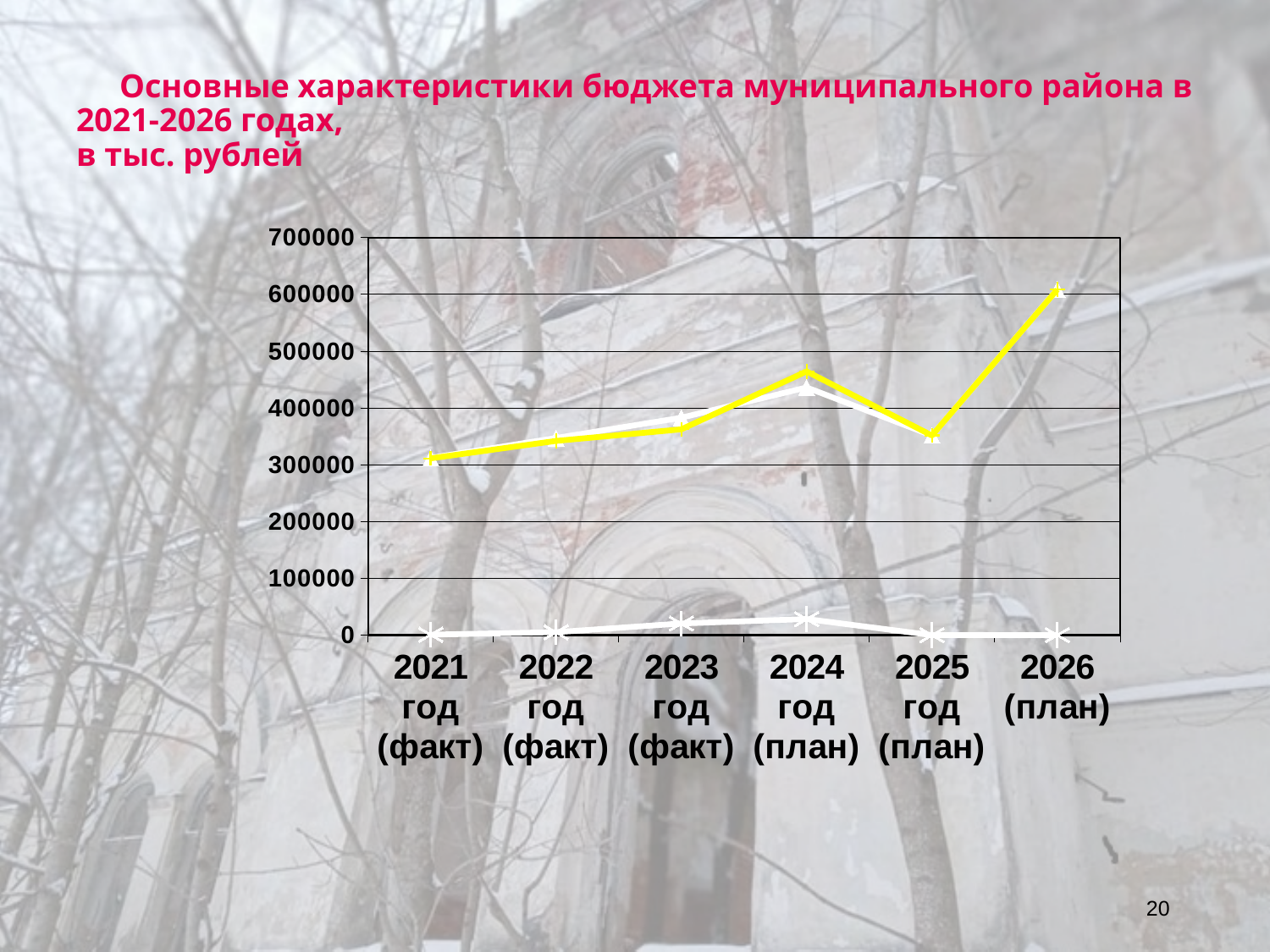
How many year categories are shown on the x axis of the chart? 6 Is the value of the yellow line for 2026 (план) greater or less than 500000? greater Is the value of the yellow line for 2025 год (план) greater or less than 400000? less Is the value of the yellow line for 2024 год (план) greater or less than 400000? greater For the yellow line, which is larger: the value for 2024 год (план) or the value for 2025 год (план)? 2024 год (план) In which year does the yellow line have its lowest value? 2021 год (факт) What kind of chart is shown on the slide? line chart What is the highest value shown on the vertical axis of the chart? 700000 Does the yellow line rise or fall from 2021 год (факт) to 2024 год (план)? rise What is the title of the slide's chart? Основные характеристики бюджета муниципального района в 2021-2026 годах, в тыс. рублей In which year does the yellow line reach its highest value? 2026 (план)